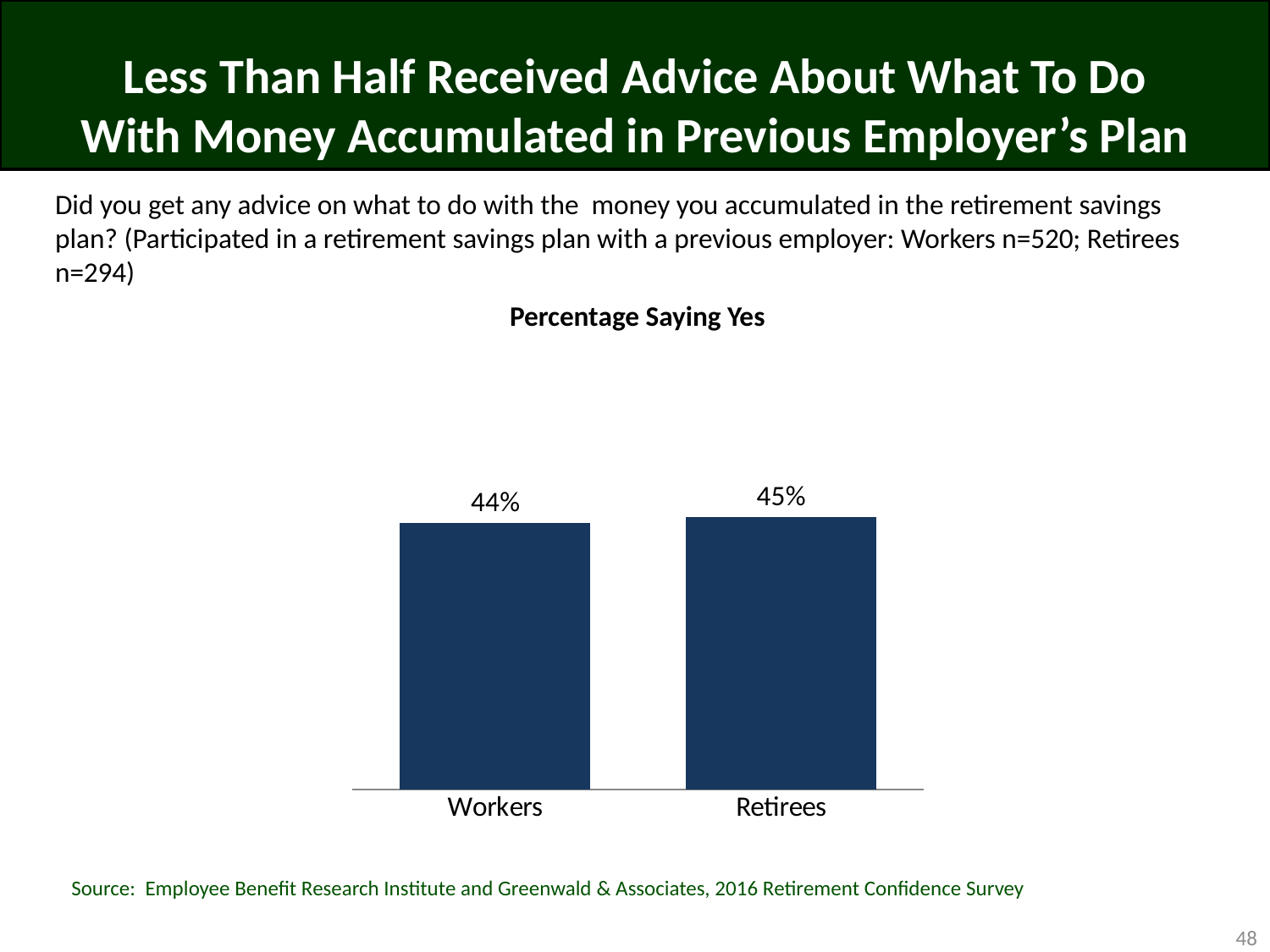
What colour are the bars in the chart? Dark blue What percentage of Workers said yes to receiving advice? 44% Which category has the lowest percentage saying yes? Workers What kind of chart is shown on the slide? Bar chart How many categories are shown in the chart? 2 What is the title of the chart? Percentage Saying Yes What percentage of Retirees said yes to receiving advice? 45% Which group has the higher percentage saying yes, Workers or Retirees? Retirees What is the difference in percentage points between Retirees and Workers saying yes? 1 percentage point Which category has the highest percentage saying yes? Retirees